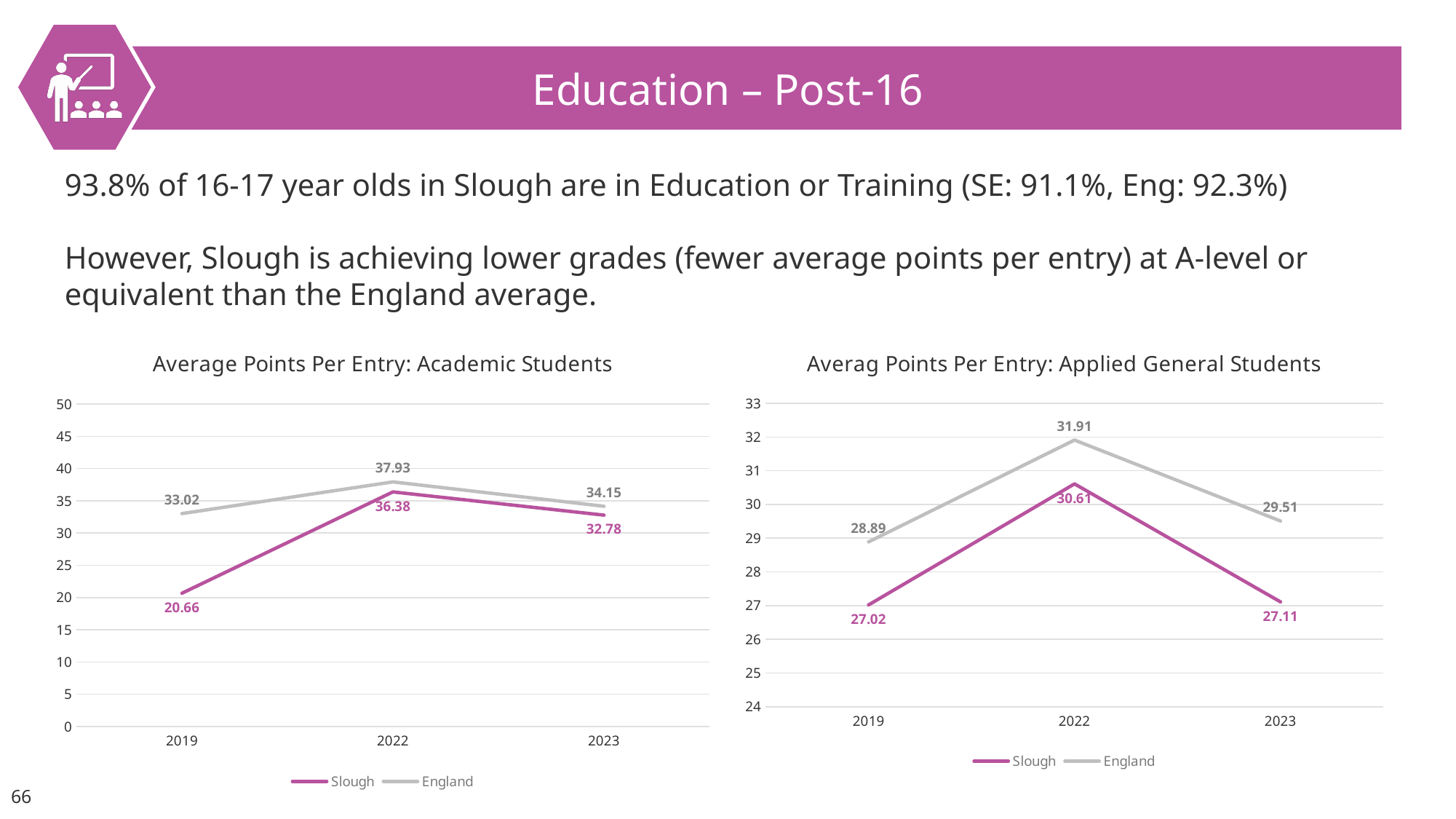
In the 'Average Points Per Entry: Academic Students' chart, which is larger in 2023: Slough or England? England In the 'Averag Points Per Entry: Applied General Students' chart, what is the value for Slough in 2023? 27.11 In the 'Average Points Per Entry: Academic Students' chart, what is the difference between England and Slough in 2019? 12.36 In the 'Average Points Per Entry: Academic Students' chart, does the Slough line rise or fall from 2022 to 2023? Fall How many series does the legend list in the 'Averag Points Per Entry: Applied General Students' chart? 2 In the 'Averag Points Per Entry: Applied General Students' chart, what is the value for England in 2019? 28.89 In the 'Average Points Per Entry: Academic Students' chart, what is the value for England in 2022? 37.93 In the 'Average Points Per Entry: Academic Students' chart, in which year is the Slough value highest? 2022 In the 'Averag Points Per Entry: Applied General Students' chart, in which year is the Slough value lowest? 2019 In the 'Averag Points Per Entry: Applied General Students' chart, what is the difference between England and Slough in 2022? 1.3 In the 'Average Points Per Entry: Academic Students' chart, what is the value for Slough in 2019? 20.66 What kind of chart is 'Average Points Per Entry: Academic Students'? Line chart